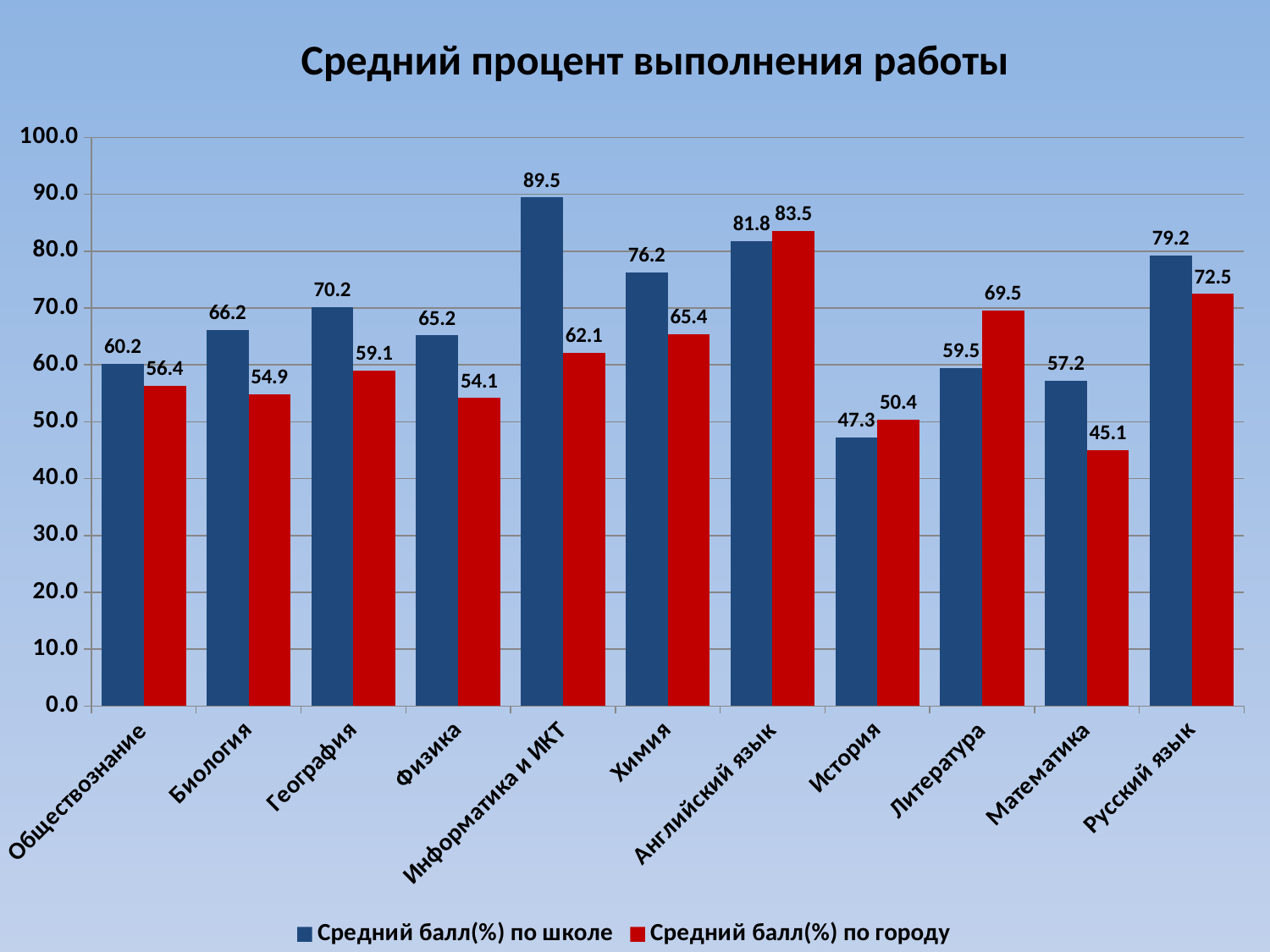
What is the value for Литература in the series Средний балл(%) по городу? 69.5 What is the difference between the Средний балл(%) по школе and Средний балл(%) по городу values for Информатика и ИКТ? 27.4 What is the value for Математика in the series Средний балл(%) по городу? 45.1 Is the value for История in the series Средний балл(%) по школе greater or less than 50.0? less For Английский язык, which series has the larger value: Средний балл(%) по школе or Средний балл(%) по городу? Средний балл(%) по городу How many categories are shown on the x axis? 11 What is the value for Информатика и ИКТ in the series Средний балл(%) по школе? 89.5 What kind of chart is shown on the slide? bar chart Which category has the highest value in the series Средний балл(%) по школе? Информатика и ИКТ How many series does the legend list? 2 Which category has the lowest value in the series Средний балл(%) по городу? Математика What is the title of the chart? Средний процент выполнения работы